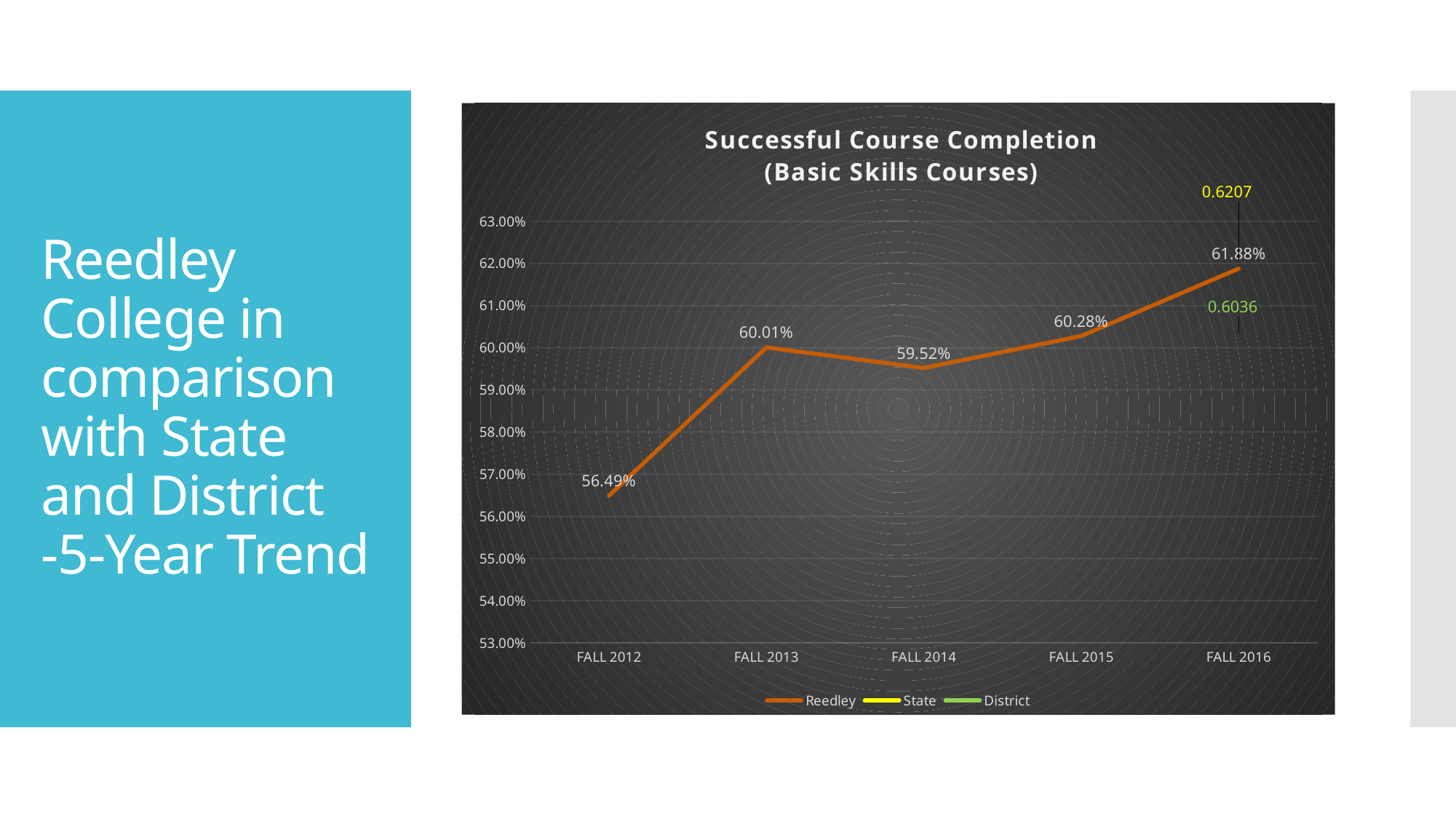
How many terms are shown on the x axis? 5 In which term is the Reedley completion rate lowest? Fall 2012 What is the Reedley value for Fall 2014? 59.52% What is the Reedley successful course completion rate for Fall 2016? 61.88% Which is larger for Reedley: the Fall 2013 value or the Fall 2014 value? Fall 2013 What value is labeled for the State series in Fall 2016? 0.6207 How many series does the legend list? 3 By how many percentage points did the Reedley rate change from Fall 2012 to Fall 2013? 3.52 What is the Reedley successful course completion rate for Fall 2012? 56.49% In which term is the Reedley completion rate highest? Fall 2016 What type of chart is shown on the slide? line chart What value is labeled for the District series in Fall 2016? 0.6036